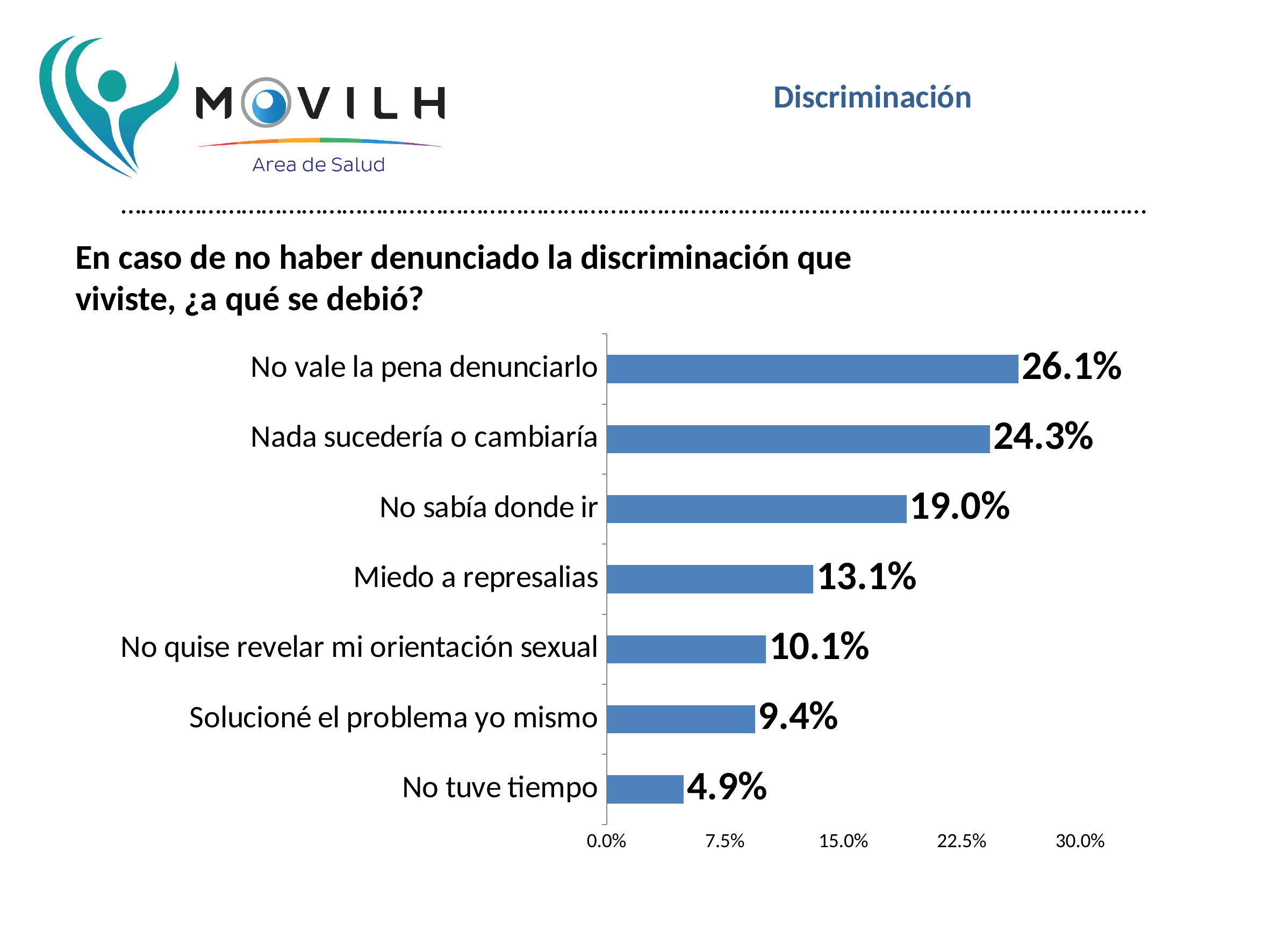
What is the difference between "Miedo a represalias" and "No tuve tiempo"? 8.2% Which category has the lowest value? No tuve tiempo Which category has the highest value? No vale la pena denunciarlo How many categories are shown in the chart? 7 What is the value for "Solucioné el problema yo mismo"? 9.4% Is the value for "No sabía donde ir" greater or less than 15.0%? greater What is the difference between "No vale la pena denunciarlo" and "Nada sucedería o cambiaría"? 1.8% What kind of chart is shown on the slide? bar chart What is the maximum value shown on the horizontal axis? 30.0% What is the value for "No vale la pena denunciarlo"? 26.1% Which is larger, "Miedo a represalias" or "No quise revelar mi orientación sexual"? Miedo a represalias What is the value for "No sabía donde ir"? 19.0%